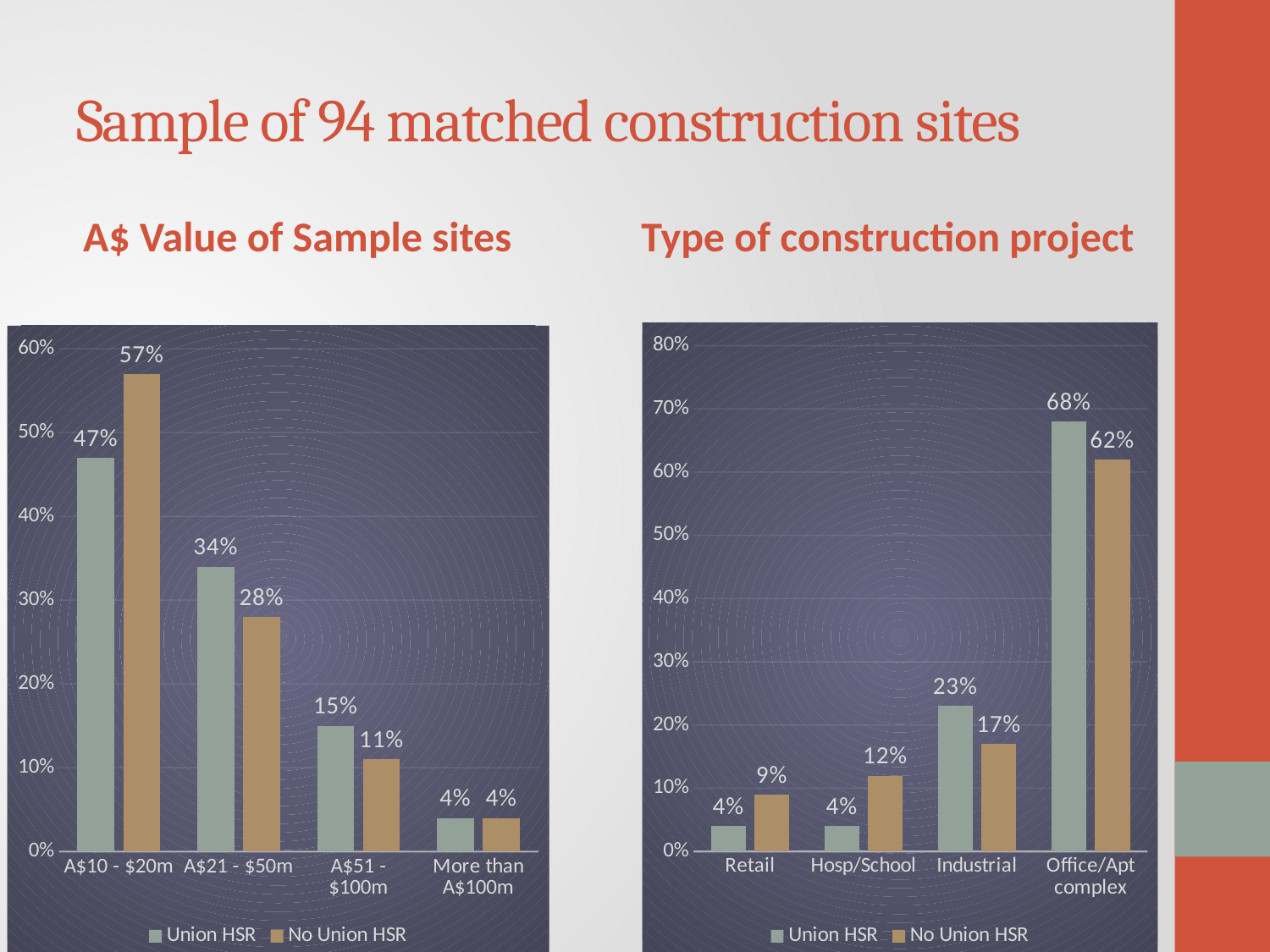
In the 'A$ Value of Sample sites' chart, what is the No Union HSR value for A$21 - $50m? 28% In the 'A$ Value of Sample sites' chart, do the Union HSR values rise or fall from left to right? fall In the 'A$ Value of Sample sites' chart, how many categories are shown on the x axis? 4 In the 'A$ Value of Sample sites' chart, what is the difference between the Union HSR and No Union HSR values for A$51 - $100m? 4% In the 'Type of construction project' chart, what is the difference between the Union HSR and No Union HSR values for Office/Apt complex? 6% In the 'Type of construction project' chart, which category has the lowest Union HSR value? Retail and Hosp/School (both 4%) How many series does the legend of the 'Type of construction project' chart list? 2 In the 'Type of construction project' chart, which is larger for Retail: Union HSR or No Union HSR? No Union HSR In the 'Type of construction project' chart, what is the No Union HSR value for Office/Apt complex? 62% In the 'Type of construction project' chart, what is the Union HSR value for Industrial? 23% In the 'A$ Value of Sample sites' chart, what is the Union HSR value for A$10 - $20m? 47% In the 'A$ Value of Sample sites' chart, which category has the highest No Union HSR value? A$10 - $20m